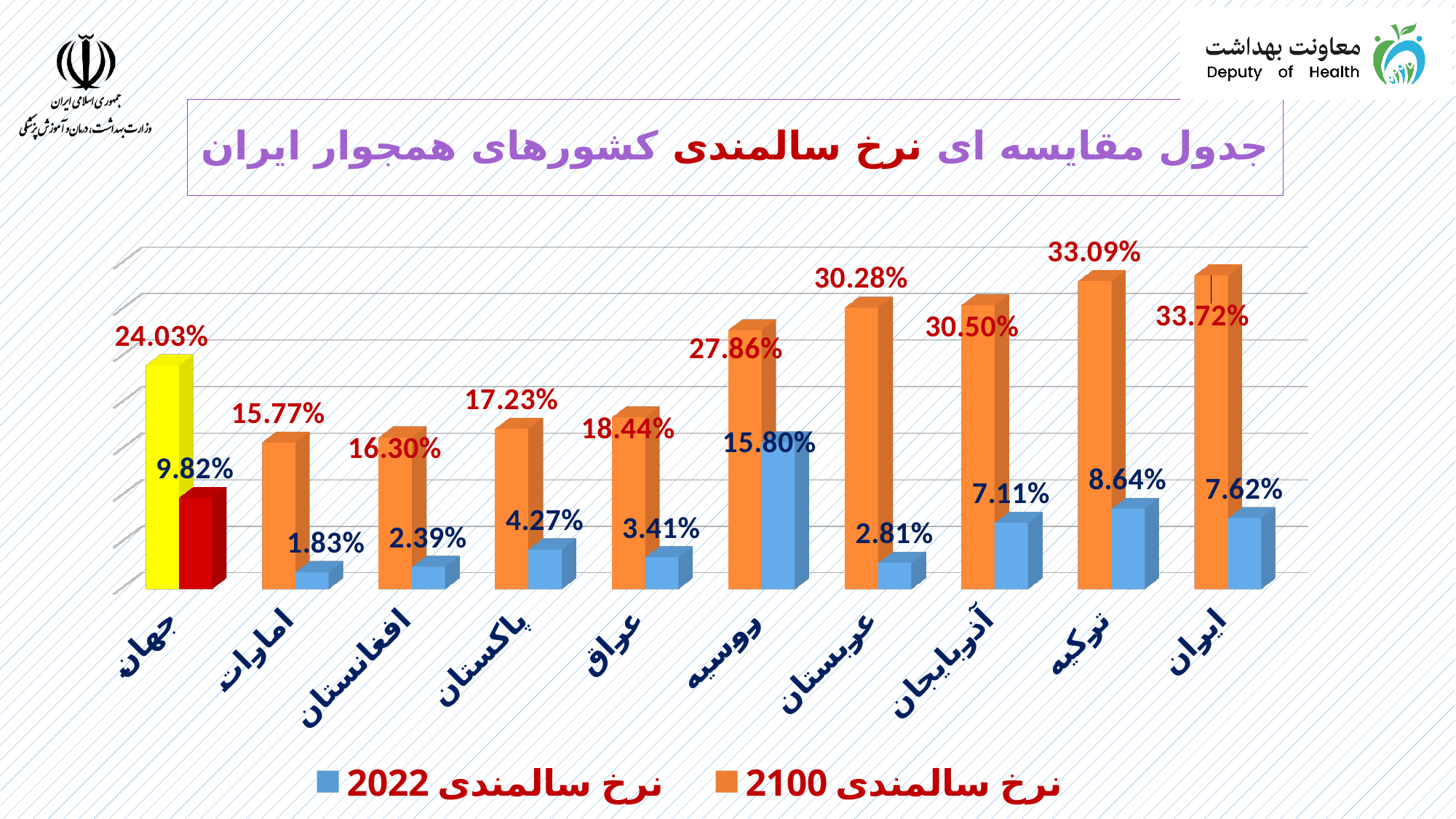
Which is larger: the 2022 aging rate for آذربایجان (Azerbaijan) or for ایران (Iran)? ایران (Iran) What is the difference between the 2100 and 2022 aging rates for ترکیه (Turkey)? 24.45% Which colour represents the نرخ سالمندی 2022 series in the legend? Blue What kind of chart is shown on the slide? Bar chart What is the value of نرخ سالمندی 2022 for روسیه (Russia)? 15.80% How many series does the legend list? 2 What is the value of نرخ سالمندی 2100 for جهان (World)? 24.03% Which category has the lowest value for نرخ سالمندی 2022? امارات (UAE) How many categories (countries/regions) are shown on the x axis? 10 What is the value of نرخ سالمندی 2022 for امارات (UAE)? 1.83% Which category has the highest value for نرخ سالمندی 2100? ایران (Iran) What is the value of نرخ سالمندی 2100 for ایران (Iran)? 33.72%